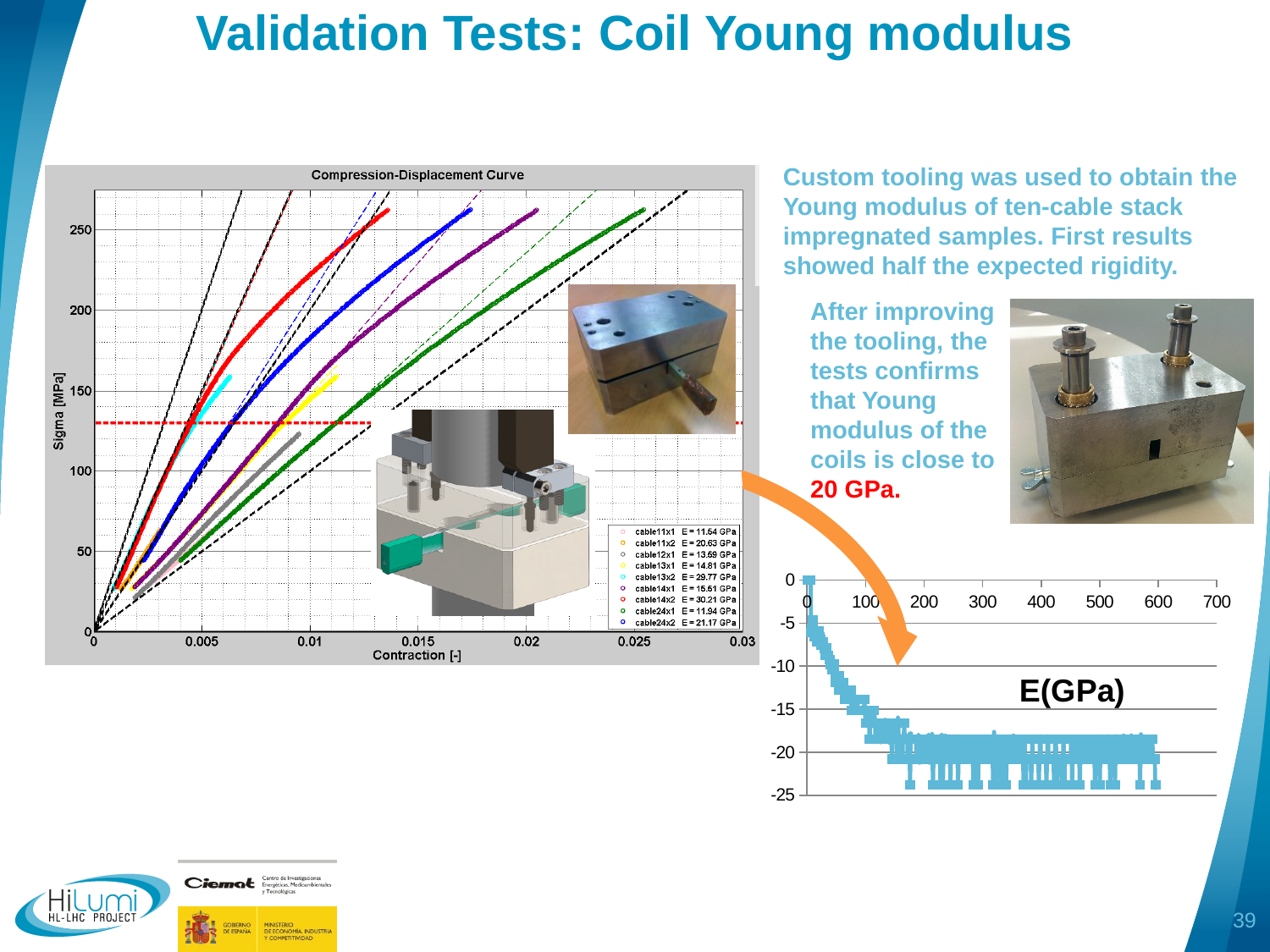
In the Compression-Displacement Curve chart, which cable has the highest E value in the legend? cable14x2 In the Compression-Displacement Curve chart, which cable has the lowest E value in the legend? cable11x1 What is the title of the chart on the left of the slide? Compression-Displacement Curve In the Compression-Displacement Curve chart, which has the larger E value, cable11x2 or cable24x2? cable24x2 In the Compression-Displacement Curve chart, how many cable series does the legend list? 9 In the E(GPa) chart at the bottom right, is the value at x = 400 greater or less than -15? less In the Compression-Displacement Curve chart, what Young modulus E is given in the legend for cable14x2? 30.21 GPa In the Compression-Displacement Curve chart, what is the difference between the E values of cable13x2 and cable13x1? 14.96 GPa In the E(GPa) chart at the bottom right, do the values rise or fall as you move along the x axis from 0 to 100? fall In the Compression-Displacement Curve chart, what Young modulus E is given in the legend for cable11x1? 11.54 GPa In the Compression-Displacement Curve chart, what is the label of the vertical axis? Sigma [MPa] What kind of chart is the E(GPa) chart at the bottom right of the slide? scatter chart